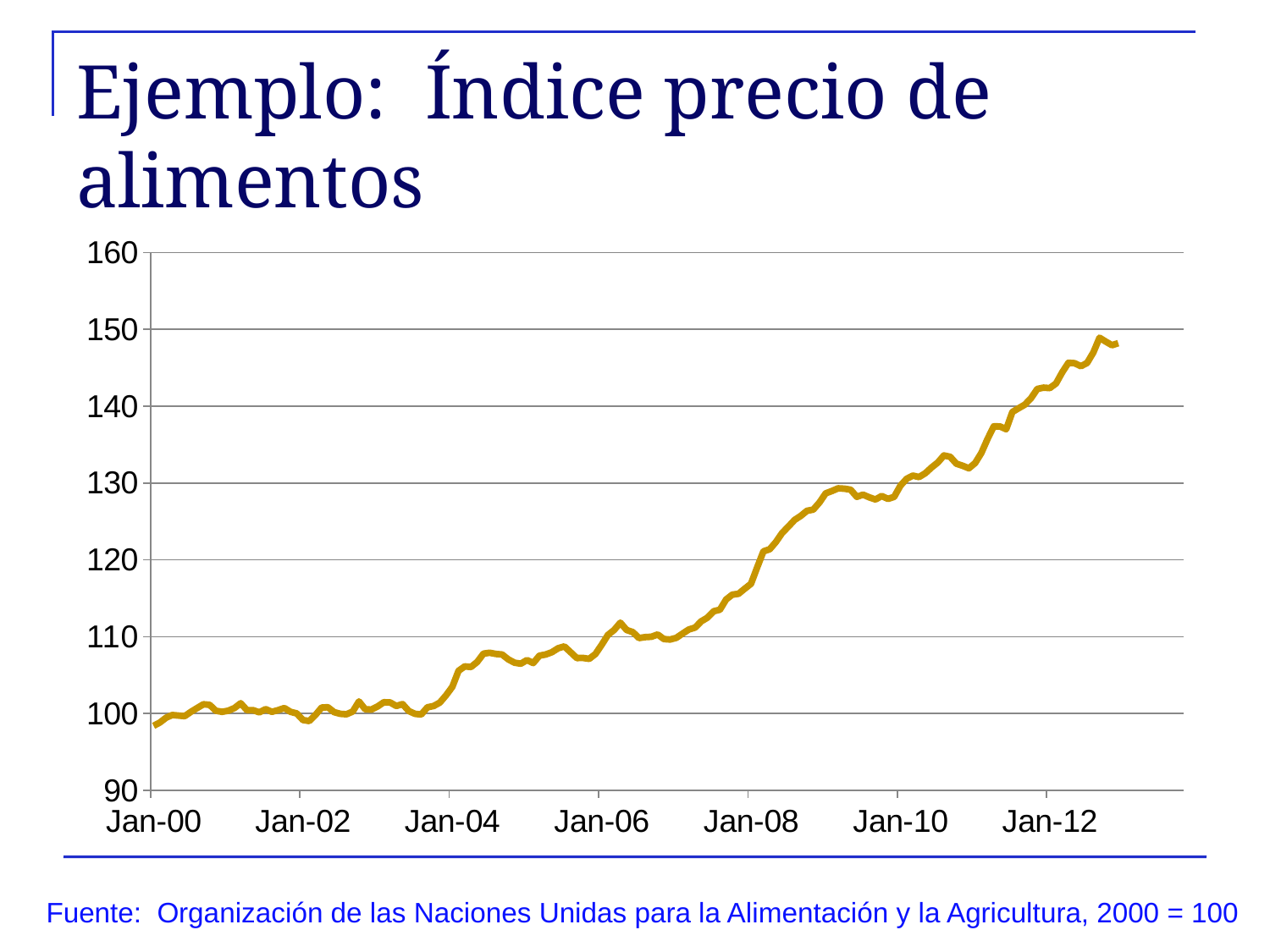
Which is larger, the index value at Jan-10 or at Jan-04? Jan-10 Is the value of the index at Jan-12 greater or less than 130? greater What kind of chart is shown on the slide? line chart Is the value of the index at Jan-02 greater or less than 110? less What is the title of the slide containing the chart? Ejemplo: Índice precio de alimentos Is the value of the index at Jan-06 greater or less than 120? less How many date labels are shown on the x axis? 7 What is the highest value shown on the y axis of the chart? 160 Does the food price index generally rise or fall from Jan-00 to Jan-12? rise